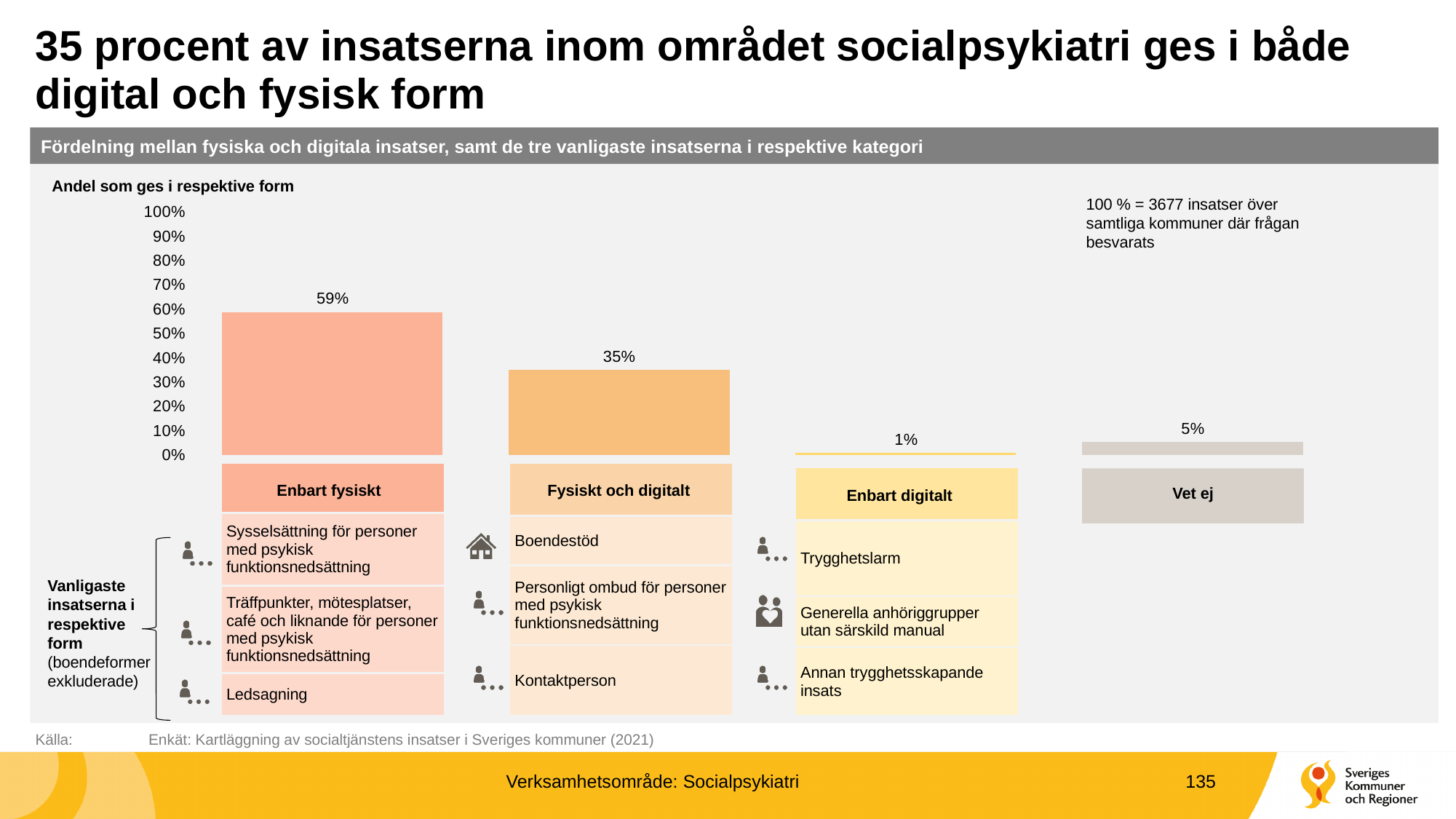
What is the value for "Enbart fysiskt"? 59% What is the value for "Vet ej"? 5% What is the difference between the values for "Enbart fysiskt" and "Fysiskt och digitalt"? 24% Is the value for "Fysiskt och digitalt" greater or less than 40%? less How many categories are shown in the chart? 4 What kind of chart is shown on the slide? bar chart Which is larger, the value for "Vet ej" or the value for "Enbart digitalt"? Vet ej Which category has the highest value? Enbart fysiskt Which category has the lowest value? Enbart digitalt What is the value for "Fysiskt och digitalt"? 35% What is the value for "Enbart digitalt"? 1% According to the note on the chart, how many insatser does 100% correspond to? 3677